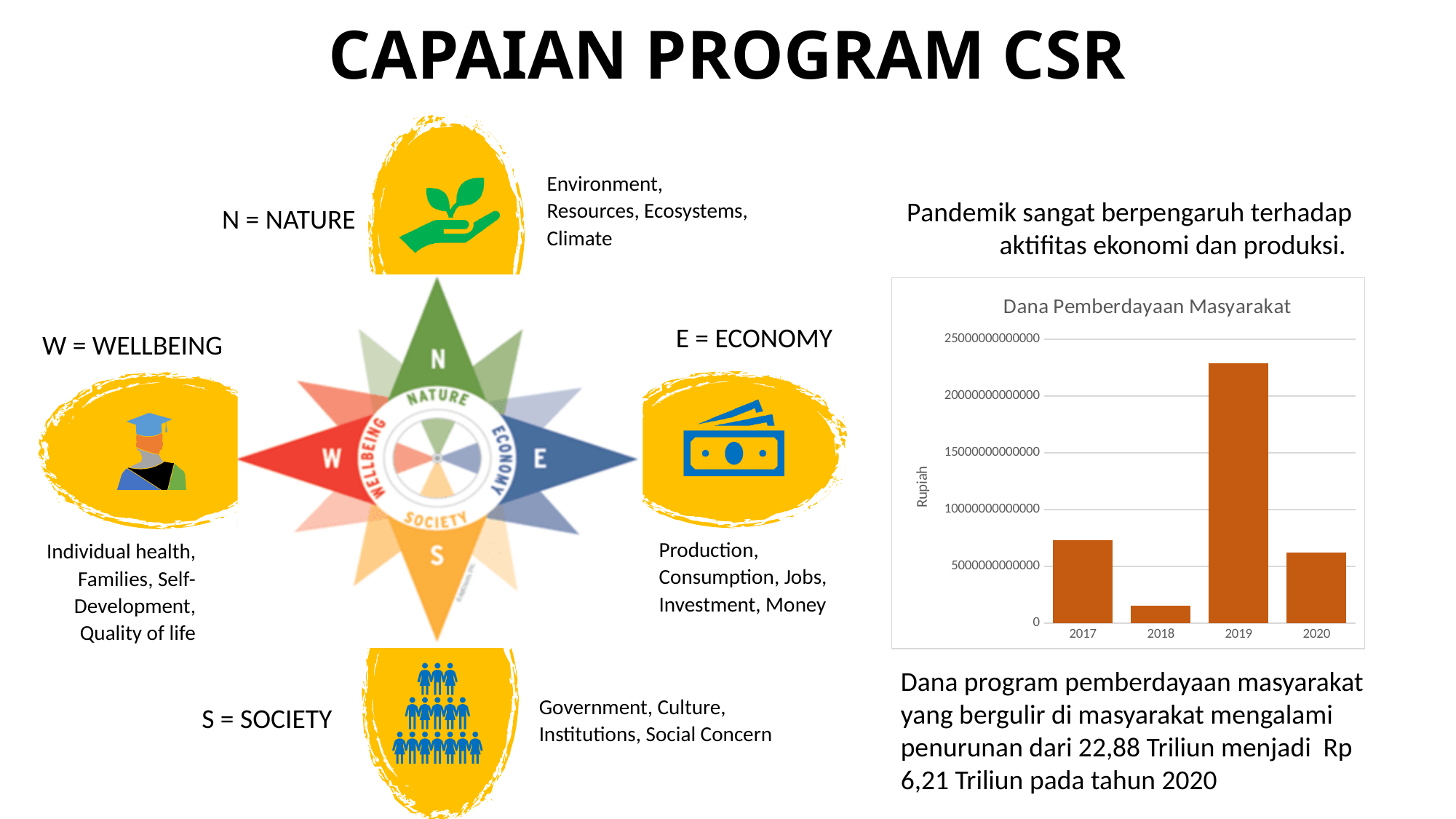
Which year has the highest value in the chart? 2019 How many years are shown on the x axis of the chart? 4 Is the value for 2019 greater or less than 20000000000000? greater Does the value rise or fall from 2019 to 2020? fall Which year has the larger value, 2017 or 2020? 2017 What is the title of the chart on the slide? Dana Pemberdayaan Masyarakat What is the label on the vertical axis of the chart? Rupiah Is the value for 2017 greater or less than 10000000000000? less Which year has the lowest value in the chart? 2018 What type of chart is shown on the slide? bar chart Is the value for 2018 greater or less than 5000000000000? less